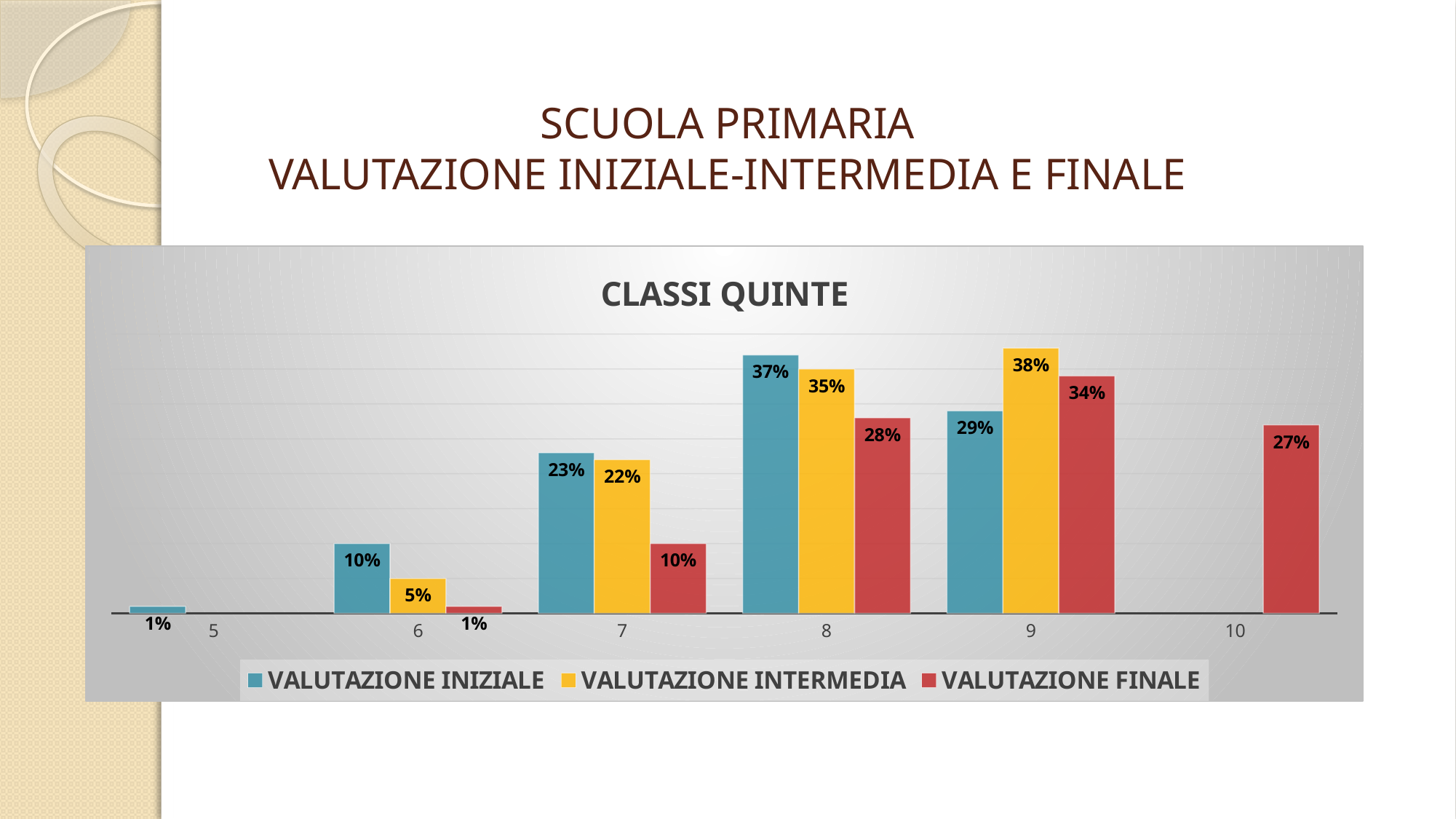
What is the VALUTAZIONE INTERMEDIA value for category 9? 38% Which category has the lowest VALUTAZIONE FINALE value? 6 What is the VALUTAZIONE FINALE value for category 7? 10% Which category has the highest VALUTAZIONE INIZIALE value? 8 What type of chart is shown on the slide? bar chart What is the difference between the VALUTAZIONE INIZIALE and VALUTAZIONE FINALE values for category 8? 9% How many categories are shown on the x axis? 6 For category 9, which is larger: VALUTAZIONE INIZIALE or VALUTAZIONE FINALE? VALUTAZIONE FINALE What is the VALUTAZIONE FINALE value for category 10? 27% What is the VALUTAZIONE INIZIALE value for category 8? 37% How many series does the legend list? 3 What is the title of the chart? CLASSI QUINTE